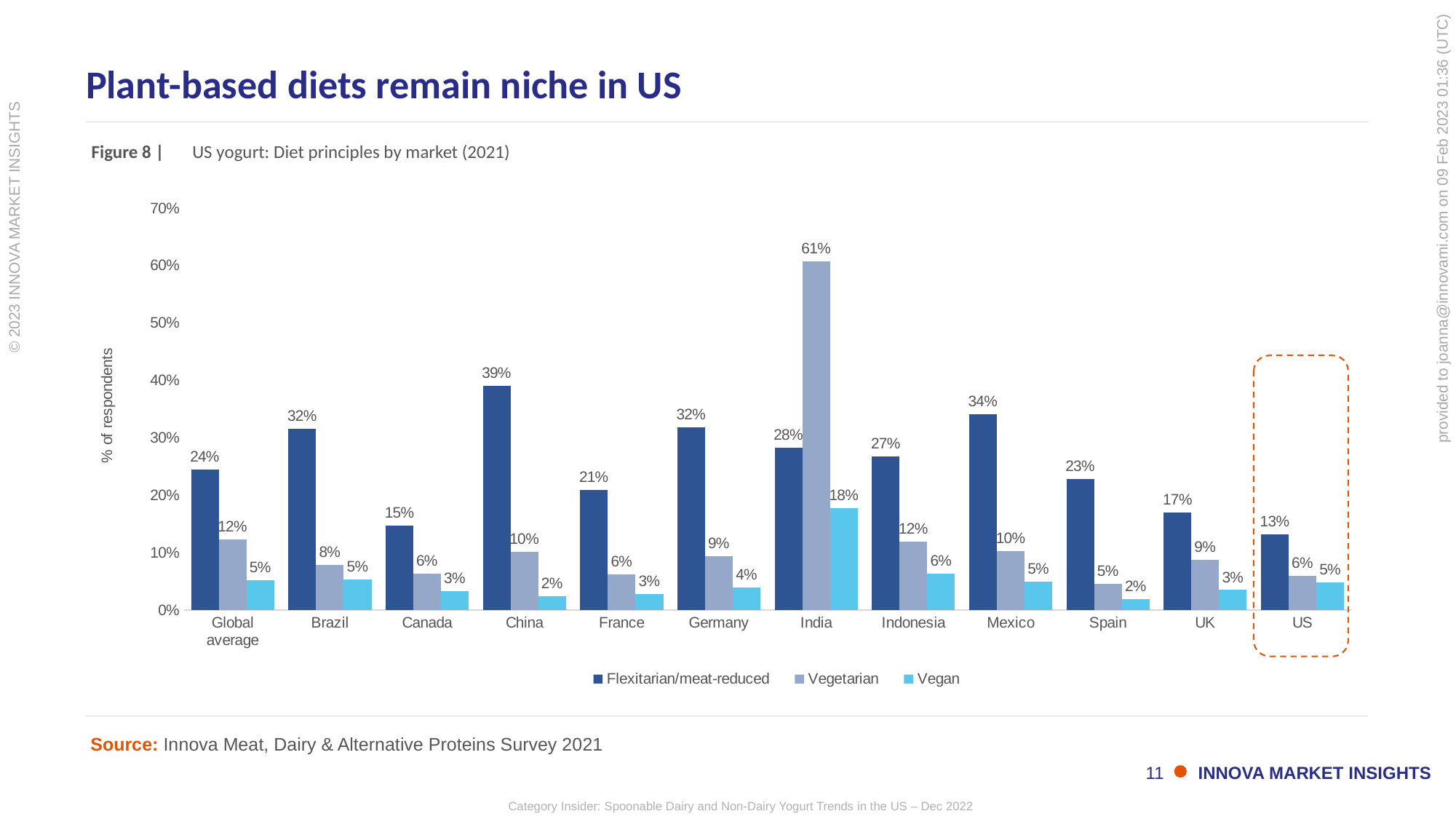
What is the Vegan value for Germany? 4% Which market has the highest Vegan value? India Which market has the lowest Flexitarian/meat-reduced value? US What is the Vegetarian value for India? 61% What is the Flexitarian/meat-reduced value for the US? 13% What kind of chart is shown on the slide? Bar chart How many series does the legend list? 3 Which market has the highest Flexitarian/meat-reduced value? China What is the difference between the Flexitarian/meat-reduced values for China and the US? 26% What is the title of Figure 8? US yogurt: Diet principles by market (2021) How many markets (categories) are shown on the x axis? 12 Which is larger, the Vegetarian value for Brazil or the Vegetarian value for Germany? Germany